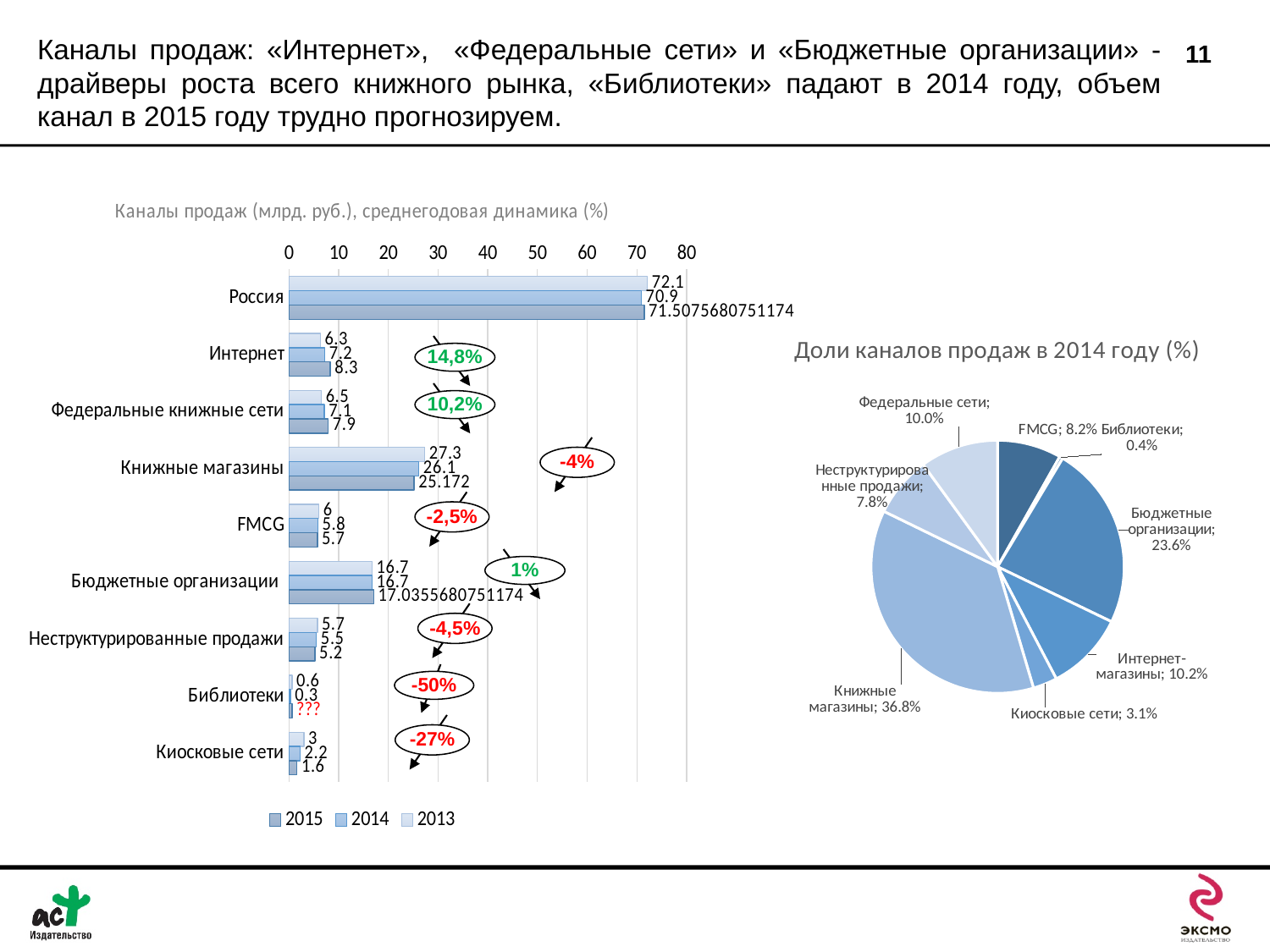
How many slices does the pie chart «Доли каналов продаж в 2014 году (%)» have? 8 In the bar chart «Каналы продаж (млрд. руб.), среднегодовая динамика (%)», what is the 2014 value for Интернет? 7.2 In the bar chart «Каналы продаж (млрд. руб.), среднегодовая динамика (%)», what is the 2013 value for Книжные магазины? 27.3 In the bar chart «Каналы продаж (млрд. руб.), среднегодовая динамика (%)», how many series does the legend list? 3 In the bar chart «Каналы продаж (млрд. руб.), среднегодовая динамика (%)», which has the larger 2015 value: Федеральные книжные сети or FMCG? Федеральные книжные сети In the pie chart «Доли каналов продаж в 2014 году (%)», which channel has the largest share? Книжные магазины In the bar chart «Каналы продаж (млрд. руб.), среднегодовая динамика (%)», do the values for Киосковые сети rise or fall from 2013 to 2015? fall In the pie chart «Доли каналов продаж в 2014 году (%)», which channel has the smallest share? Библиотеки In the pie chart «Доли каналов продаж в 2014 году (%)», what share do Бюджетные организации have? 23.6% In the bar chart «Каналы продаж (млрд. руб.), среднегодовая динамика (%)», how many categories are shown on the vertical axis? 9 In the bar chart «Каналы продаж (млрд. руб.), среднегодовая динамика (%)», what is the difference between the 2015 and 2013 values for Интернет? 2 What kind of chart is the chart titled «Каналы продаж (млрд. руб.), среднегодовая динамика (%)»? bar chart